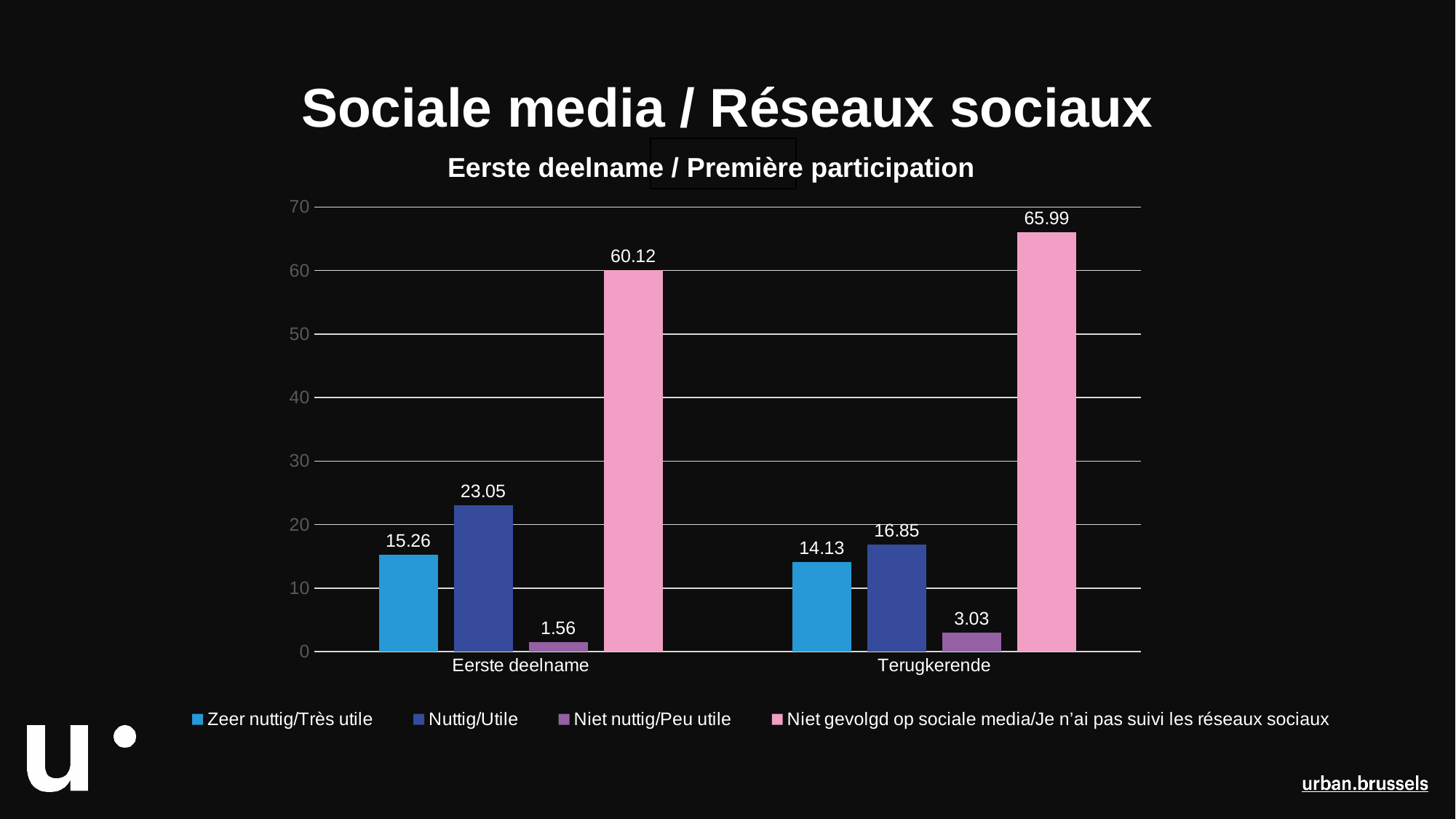
How many series does the legend list? 4 What is the value for Zeer nuttig/Très utile in the Terugkerende group? 14.13 What is the value for Niet nuttig/Peu utile in the Eerste deelname group? 1.56 What is the value for Nuttig/Utile in the Eerste deelname group? 23.05 What is the difference between the Nuttig/Utile values for Eerste deelname and Terugkerende? 6.20 Which series has the lowest value in the Eerste deelname group? Niet nuttig/Peu utile Which series has the highest value in the Terugkerende group? Niet gevolgd op sociale media/Je n'ai pas suivi les réseaux sociaux What is the value for Niet gevolgd op sociale media/Je n'ai pas suivi les réseaux sociaux in the Terugkerende group? 65.99 Is the value for Niet gevolgd op sociale media in the Eerste deelname group greater or less than 50? greater How many categories are shown on the x axis? 2 What kind of chart is shown on the slide? Bar chart Which is larger: Zeer nuttig/Très utile for Eerste deelname or for Terugkerende? Eerste deelname